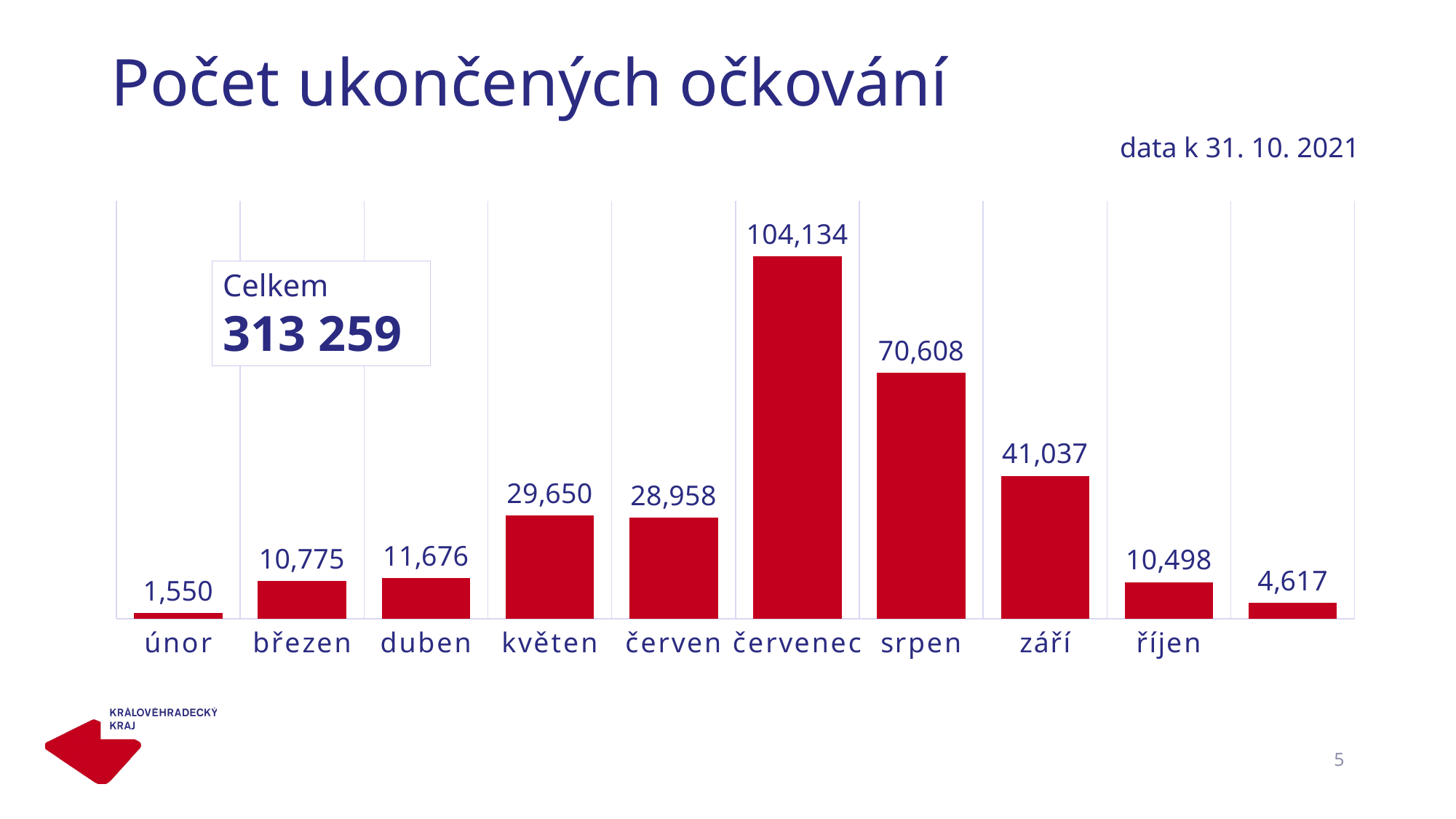
What is the difference between the values for červenec and srpen? 33,526 Which labelled month has the lowest value? únor Which is larger, the value for květen or the value for červen? květen Which month has the highest value? červenec Which is larger, the value for březen or the value for duben? duben What kind of chart is shown on the slide? bar chart What is the value for červenec? 104,134 What is the difference between the values for srpen and září? 29,571 What is the value for říjen? 10,498 What is the value for únor? 1,550 Do the values rise or fall from červenec to říjen? fall What is the value for září? 41,037